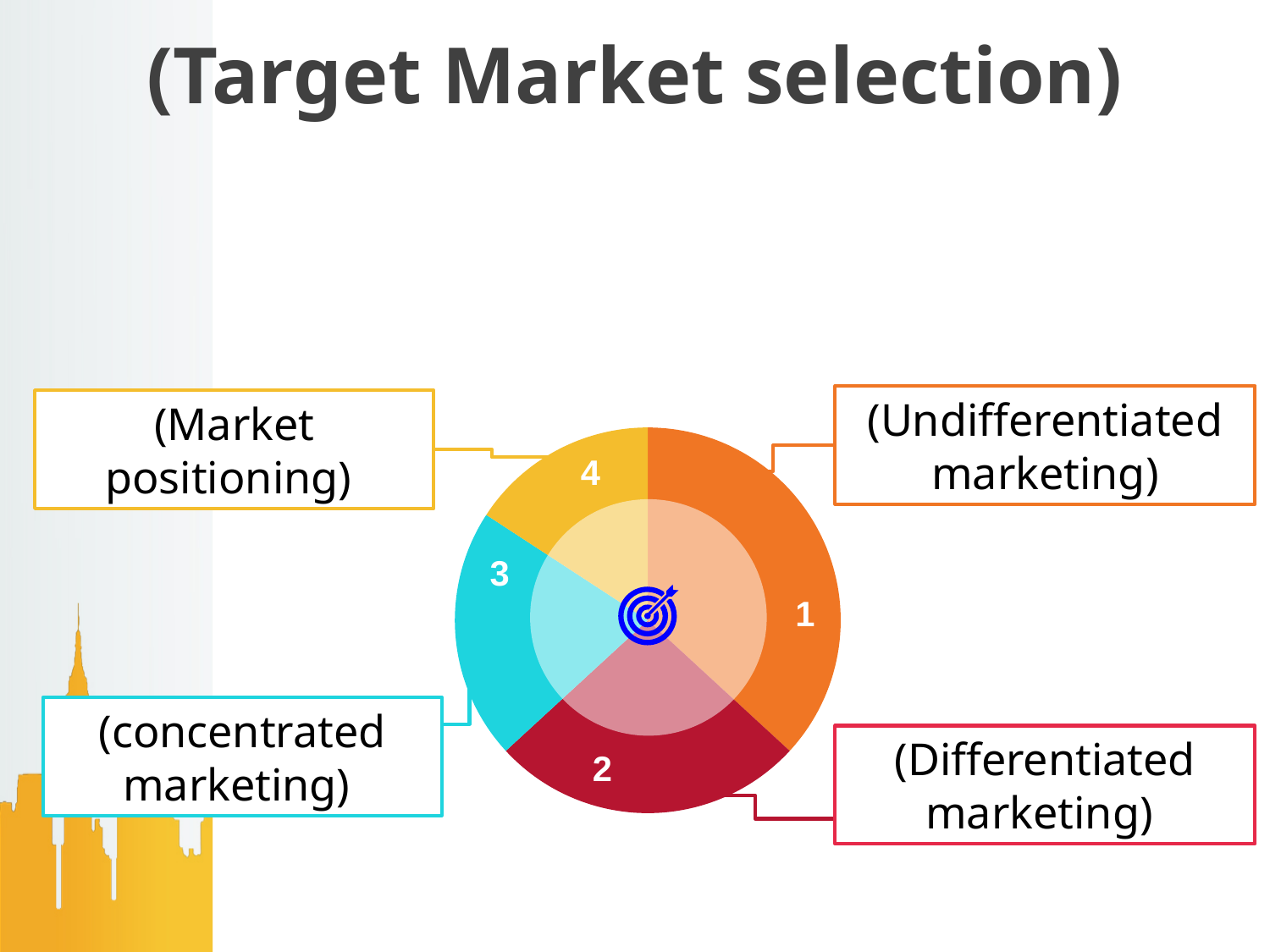
Which label is connected to segment 3 of the pie chart? (concentrated marketing) Which is larger in the pie chart, segment 2 or segment 4? segment 2 Which segment of the pie chart is the largest? 1 (Undifferentiated marketing) Which label is connected to segment 1 of the pie chart? (Undifferentiated marketing) What is the title of the slide containing the pie chart? (Target Market selection) Which label is connected to segment 4 of the pie chart? (Market positioning) What kind of chart is shown on the slide? pie chart How many segments does the pie chart have? 4 Which label is connected to segment 2 of the pie chart? (Differentiated marketing) What colour is segment 3 of the pie chart? cyan Which is larger in the pie chart, segment 1 or segment 4? segment 1 Which segment of the pie chart is the smallest? 4 (Market positioning)